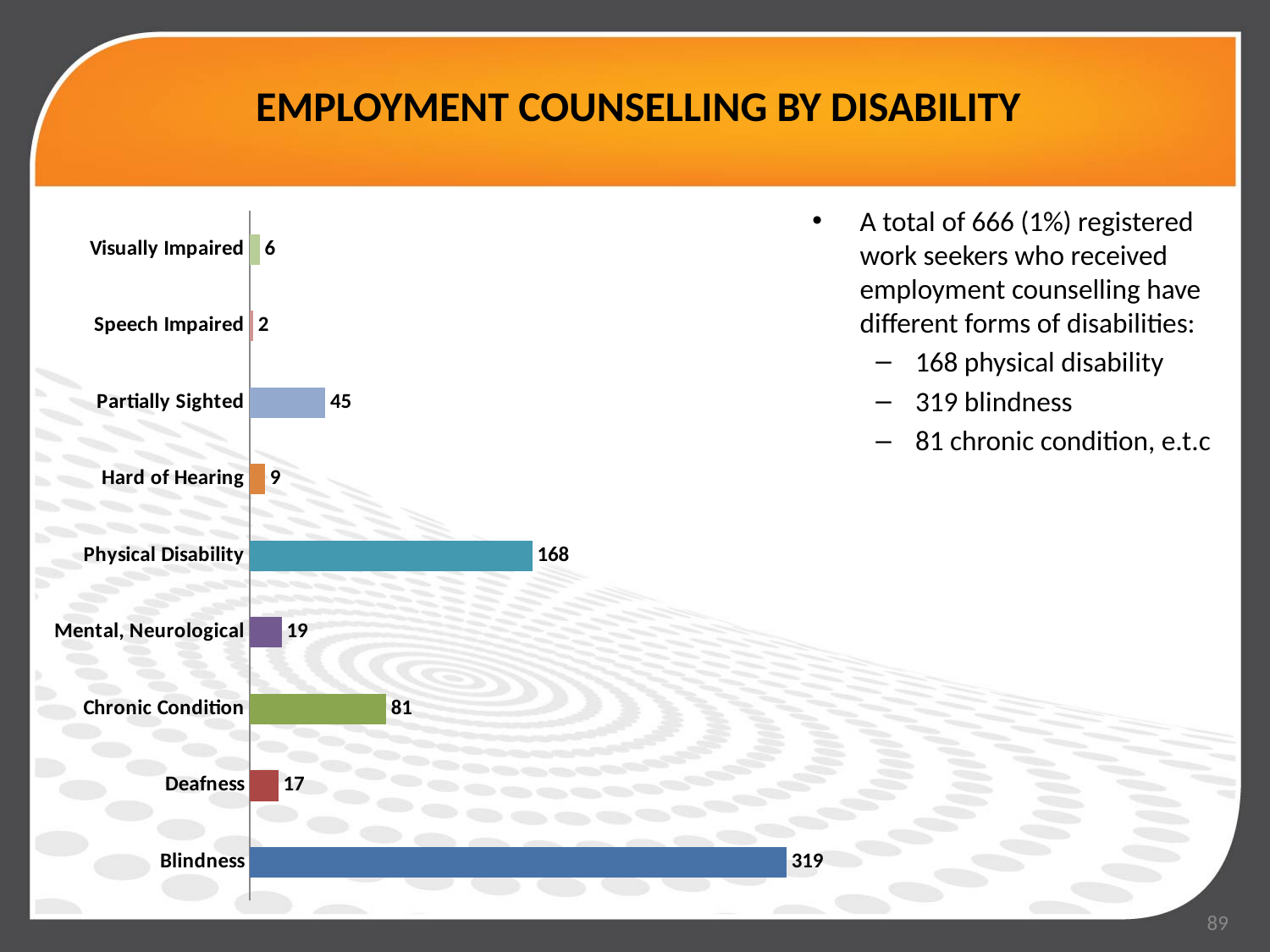
What is the value for Blindness? 319 Which is larger, the value for Deafness or the value for Mental, Neurological? Mental, Neurological What is the value for Partially Sighted? 45 How many categories are shown in the chart? 9 Which category has the highest value? Blindness What is the difference between the values for Blindness and Physical Disability? 151 What is the value for Physical Disability? 168 What is the title of the slide containing the chart? EMPLOYMENT COUNSELLING BY DISABILITY What is the difference between the values for Chronic Condition and Partially Sighted? 36 What is the value for Speech Impaired? 2 What kind of chart is shown on the slide? Bar chart Which category has the lowest value? Speech Impaired